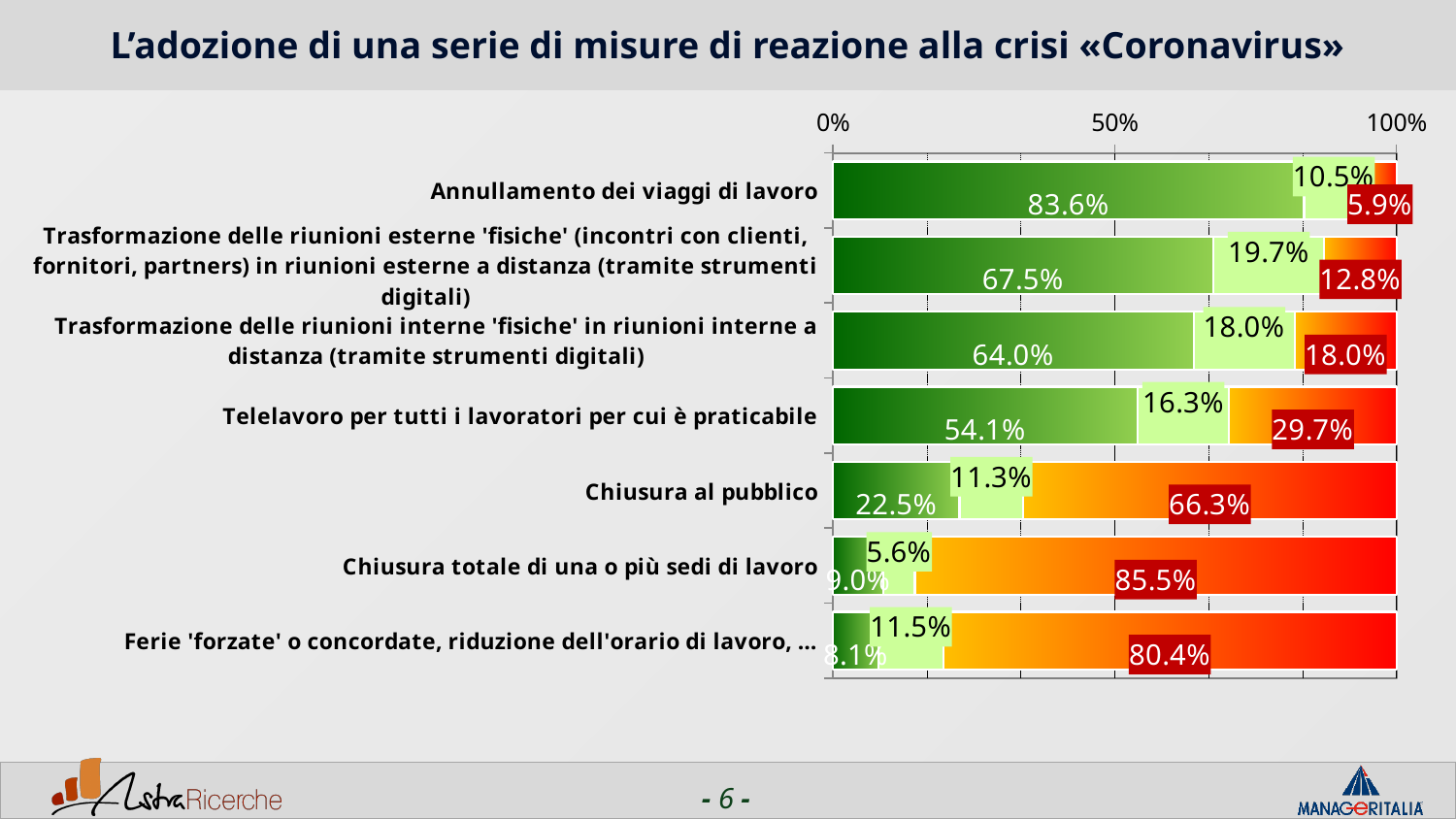
What is the value of the red segment for 'Chiusura totale di una o più sedi di lavoro'? 85.5% Is the dark green value for 'Trasformazione delle riunioni interne fisiche in riunioni interne a distanza' greater or less than 50%? greater What is the title of the chart on the slide? L'adozione di una serie di misure di reazione alla crisi «Coronavirus» What is the value of the dark green segment for 'Annullamento dei viaggi di lavoro'? 83.6% How many measures (categories) are listed on the chart? 7 Which measure has the lowest red segment value? Annullamento dei viaggi di lavoro What is the value of the light green segment for 'Telelavoro per tutti i lavoratori per cui è praticabile'? 16.3% What kind of chart is shown on the slide? Stacked bar chart What is the difference between the dark green values for 'Annullamento dei viaggi di lavoro' (83.6%) and 'Telelavoro per tutti i lavoratori per cui è praticabile' (54.1%)? 29.5% Which is larger: the red segment for 'Chiusura totale di una o più sedi di lavoro' or the red segment for 'Ferie forzate o concordate, riduzione dell'orario di lavoro'? Chiusura totale di una o più sedi di lavoro Which measure has the highest dark green segment value? Annullamento dei viaggi di lavoro What is the value of the red segment for 'Chiusura al pubblico'? 66.3%